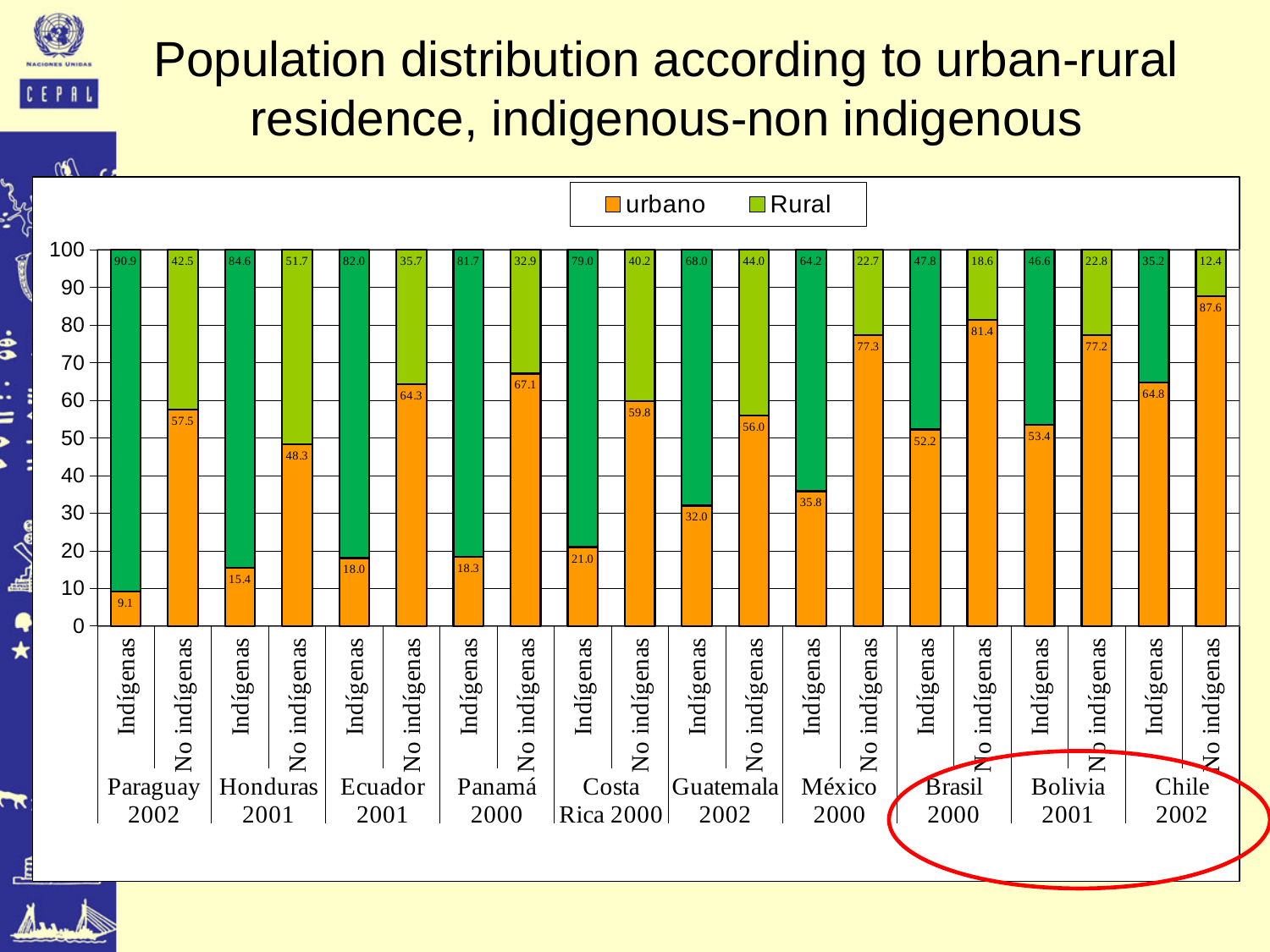
What is the difference between the urbano values for No indígenas and Indígenas in Honduras 2001? 32.9 What is the total of the stacked bar for Indígenas in Brasil 2000? 100.0 How many series does the legend list? 2 Which countries are circled in red on the chart? Brasil 2000, Bolivia 2001, Chile 2002 What is the Rural value for No indígenas in Chile 2002? 12.4 Which bar has the lowest urbano value? Indígenas, Paraguay 2002 Which bar has the highest urbano value? No indígenas, Chile 2002 What kind of chart is shown on the slide? Stacked bar chart What is the urbano value for Indígenas in Paraguay 2002? 9.1 What is the urbano value for No indígenas in México 2000? 77.3 Which is larger: the Rural value for Indígenas in Guatemala 2002 or the Rural value for Indígenas in México 2000? Indígenas, Guatemala 2002 How many bars are plotted in the chart? 20